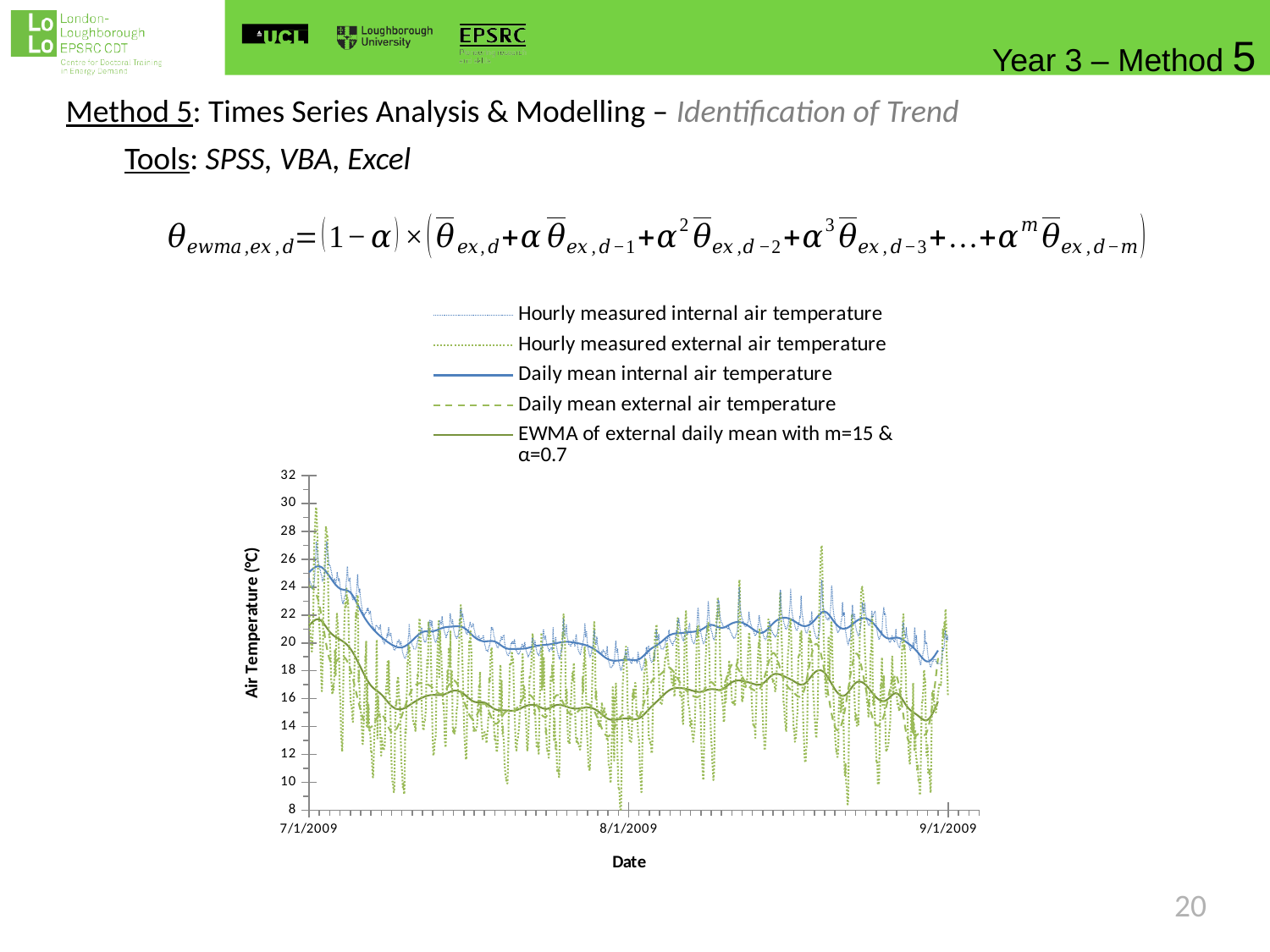
What is the last date shown on the x axis of the chart? 9/1/2009 Is the daily mean internal air temperature at 7/1/2009 greater or less than 24? greater What is the highest value shown on the y axis of the chart? 32 What kind of chart is shown on the slide? line chart Does the daily mean internal air temperature rise or fall between 7/1/2009 and mid-July 2009? fall What is the label of the x axis of the chart? Date At 8/1/2009, which is larger: the daily mean internal air temperature or the EWMA of external daily mean? daily mean internal air temperature What is the first date shown on the x axis of the chart? 7/1/2009 What is the label of the y axis of the chart? Air Temperature (°C) What is the lowest value shown on the y axis of the chart? 8 Is the EWMA of external daily mean at 8/1/2009 greater or less than 18? less How many series does the chart legend list? 5